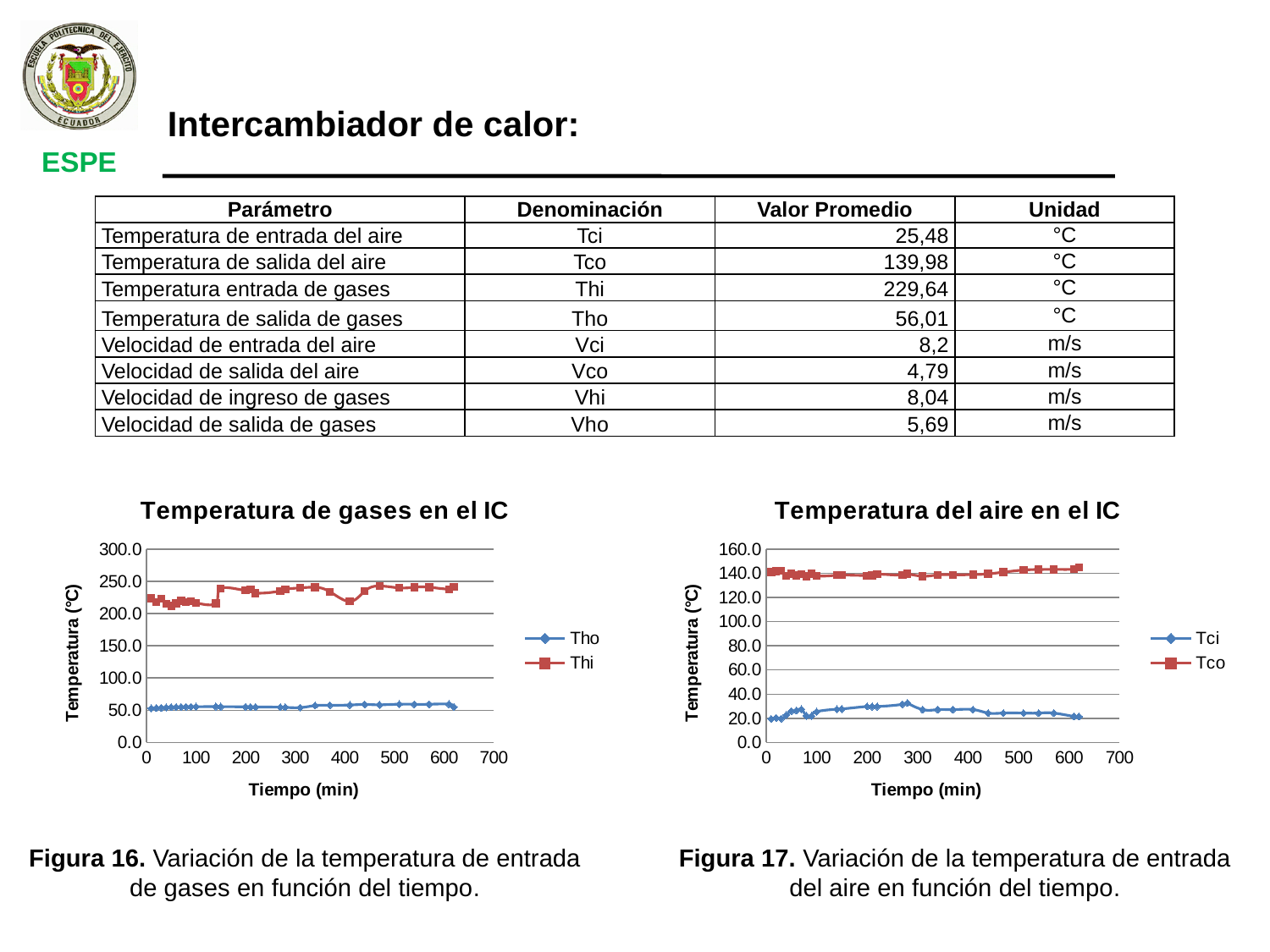
How many series does the legend of "Temperatura del aire en el IC" list? 2 In "Temperatura del aire en el IC", which series has higher values, Tci or Tco? Tco How many series does the legend of "Temperatura de gases en el IC" list? 2 What is the x-axis label of the chart "Temperatura de gases en el IC"? Tiempo (min) In "Temperatura de gases en el IC", are the values for Tho greater or less than 100? less In "Temperatura de gases en el IC", which series has higher values, Thi or Tho? Thi What kind of chart is "Temperatura de gases en el IC"? Line chart What kind of chart is "Temperatura del aire en el IC"? Line chart In "Temperatura de gases en el IC", are the values for Thi greater or less than 200? greater Which series are listed in the legend of "Temperatura del aire en el IC"? Tci and Tco In "Temperatura del aire en el IC", are the values for Tco greater or less than 120? greater